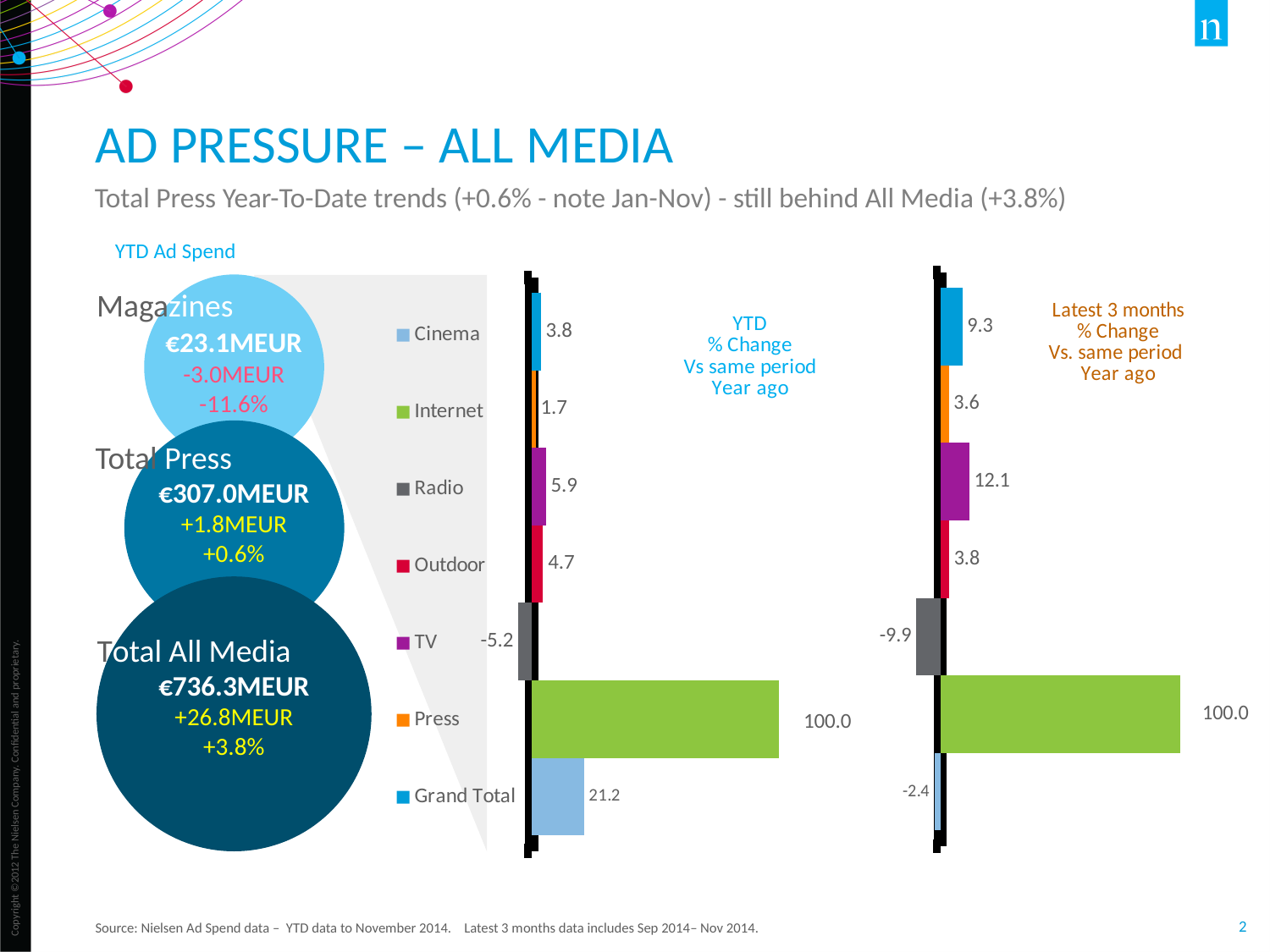
In the 'YTD % Change Vs same period Year ago' chart, what is the value for Grand Total? 3.8 How much higher is the Cinema value in the 'Latest 3 months' chart than in the 'YTD' chart? -23.6 (it is 23.6 lower: -2.4 vs 21.2) In the 'Latest 3 months % Change Vs. same period Year ago' chart, what is the value for Cinema? -2.4 How many bars are plotted in the 'YTD % Change Vs same period Year ago' chart? 7 How many entries does the legend list for the bar charts? 7 Is the Cinema value larger in the 'YTD % Change' chart or in the 'Latest 3 months % Change' chart? YTD % Change In the 'Latest 3 months % Change Vs. same period Year ago' chart, what is the value for Grand Total? 9.3 In the 'Latest 3 months % Change Vs. same period Year ago' chart, what is the lowest value shown? -9.9 What kind of chart is the 'YTD % Change Vs same period Year ago' chart? bar chart In the 'YTD % Change Vs same period Year ago' chart, what is the largest value shown? 100.0 In the 'YTD % Change Vs same period Year ago' chart, what is the value for Cinema? 21.2 In the 'YTD % Change Vs same period Year ago' chart, what is the lowest value shown? -5.2